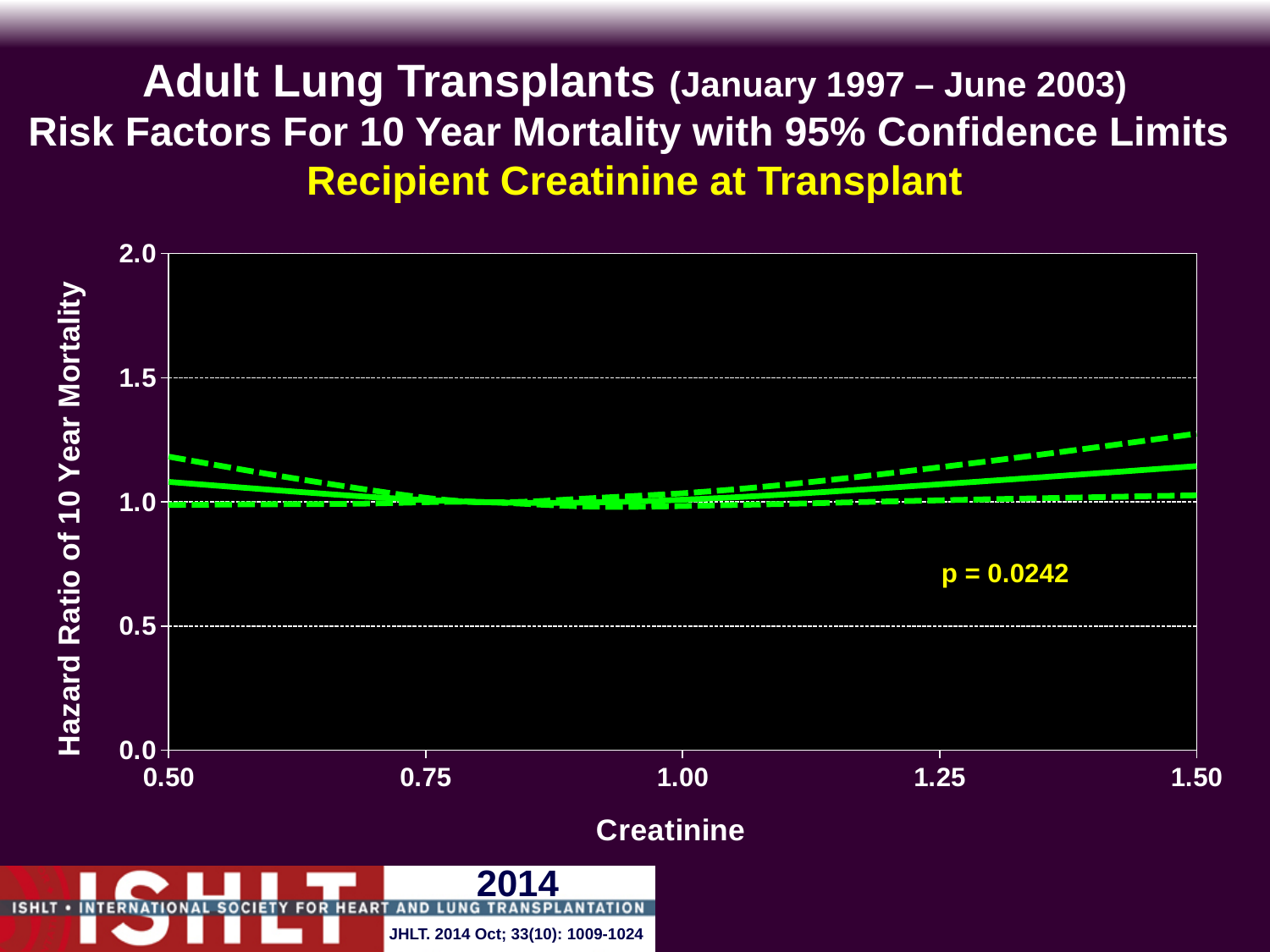
Does the hazard ratio (solid line) rise or fall as creatinine increases from 0.50 to 0.75? fall What is the label of the x axis? Creatinine What kind of chart is shown on the slide? line chart What is the p-value printed on the chart? p = 0.0242 Is the upper 95% confidence limit (upper dashed line) at a creatinine of 1.50 greater or less than 1.5? less Does the hazard ratio (solid line) rise or fall as creatinine increases from 1.00 to 1.50? rise How many lines are plotted on the chart? 3 Is the upper 95% confidence limit (upper dashed line) at a creatinine of 0.50 greater or less than 1.0? greater Is the hazard ratio (solid line) at a creatinine of 1.50 greater or less than 1.0? greater Is the hazard ratio (solid line) higher at a creatinine of 1.50 or at a creatinine of 0.75? 1.50